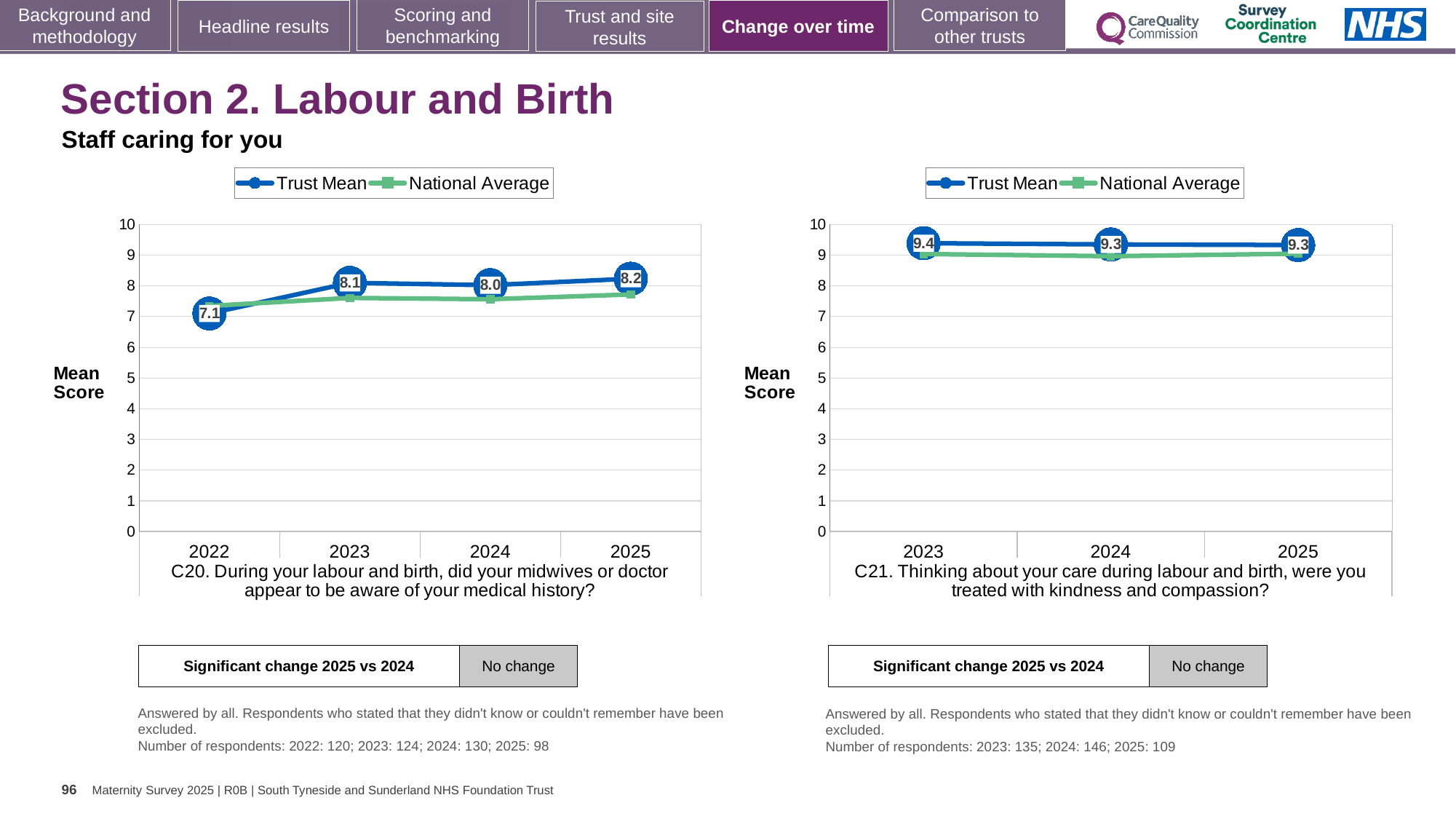
In the C21 chart (right), what is the Trust Mean for 2025? 9.3 In the C20 chart (left), which year has the highest Trust Mean? 2025 In the C20 chart (left), is the Trust Mean for 2023 larger or smaller than the Trust Mean for 2024? larger In the C20 chart (left), how many years are shown on the x axis? 4 In the C20 chart (left), what is the Trust Mean for 2025? 8.2 How many series does the legend of the C21 chart (right) list? 2 In the C20 chart (left), which year has the lowest Trust Mean? 2022 In the C21 chart (right), what is the Trust Mean for 2023? 9.4 What kind of chart is the C20 chart (left)? line chart In the C20 chart (left), what is the difference between the Trust Mean for 2025 and 2022? 1.1 In the C20 chart (left), what is the Trust Mean for 2022? 7.1 In the C21 chart (right), is the National Average for 2024 greater or less than 8? greater